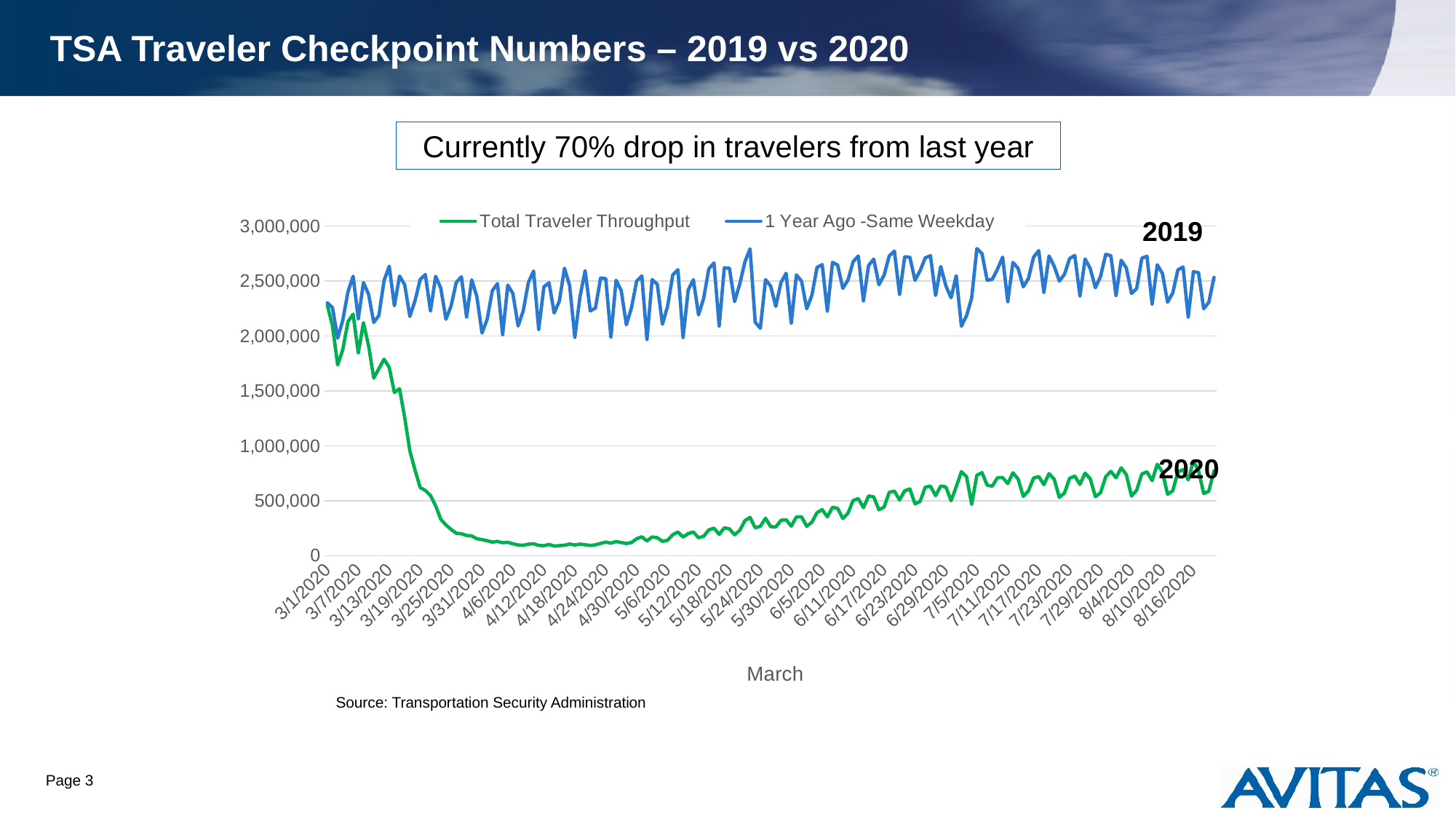
Does the Total Traveler Throughput line rise or fall between 4/18/2020 and 8/16/2020? Rise Is the Total Traveler Throughput value on 8/16/2020 greater or less than 1,000,000? less Does the Total Traveler Throughput line rise or fall between 3/1/2020 and 4/12/2020? Fall What colour is the Total Traveler Throughput (2020) line? Green Is the Total Traveler Throughput value on 4/12/2020 greater or less than 500,000? less What kind of chart is shown on the slide? Line chart Is the Total Traveler Throughput value on 3/1/2020 greater or less than 2,000,000? greater What are the two series named in the chart legend? Total Traveler Throughput; 1 Year Ago -Same Weekday On 6/5/2020, which series has the higher value: Total Traveler Throughput or 1 Year Ago -Same Weekday? 1 Year Ago -Same Weekday What is the highest value shown on the chart's vertical axis? 3,000,000 How many series does the chart legend list? 2